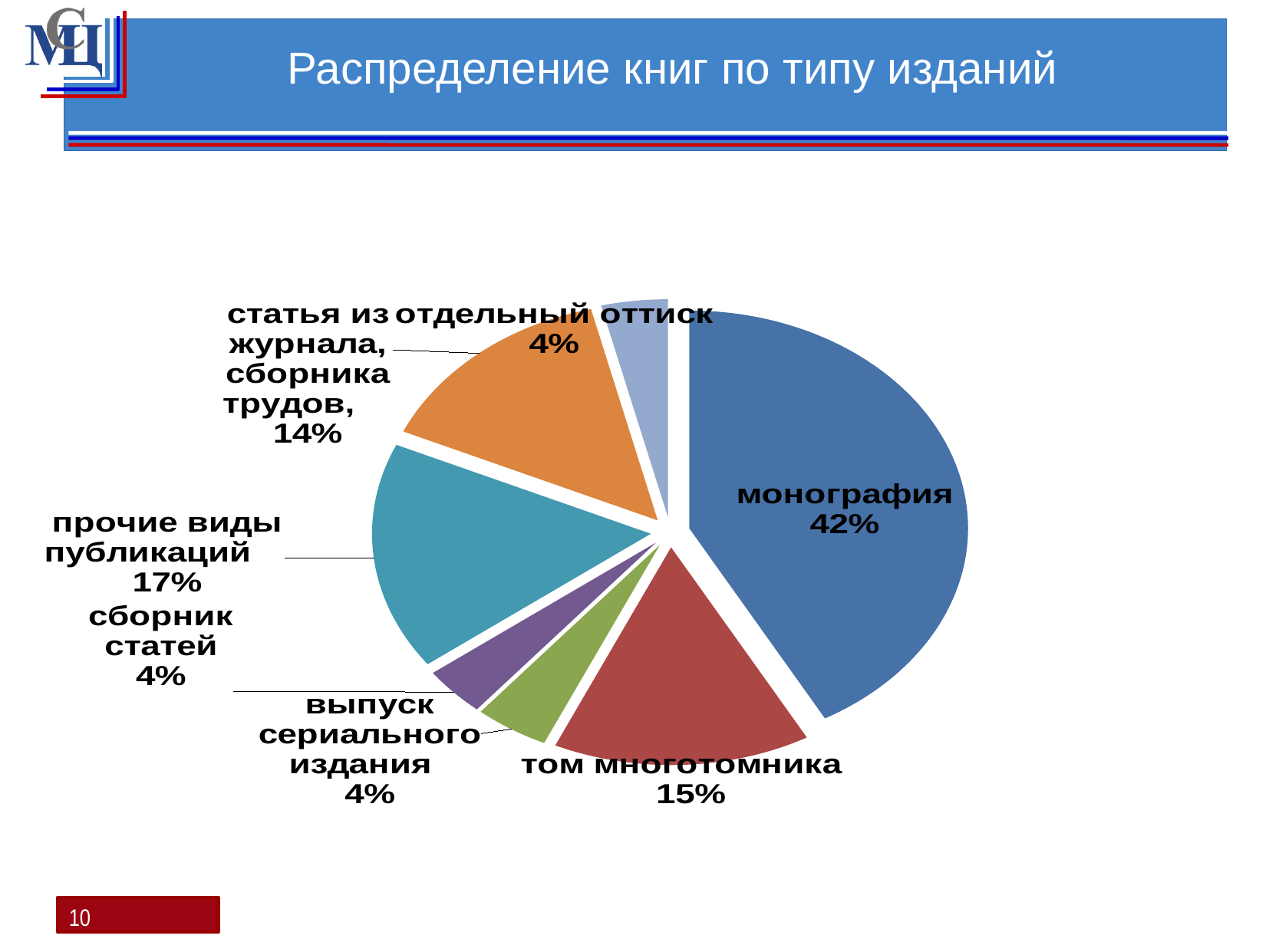
Which is larger, the share of прочие виды публикаций or the share of статья из журнала, сборника трудов? прочие виды публикаций What is the title of the chart on the slide? Распределение книг по типу изданий What share of the pie does прочие виды публикаций have? 17% What share of the pie does том многотомника have? 15% How many slices does the pie chart have? 7 What share of the pie does выпуск сериального издания have? 4% Which category has the largest slice of the pie? монография What is the difference between the shares of монография and том многотомника? 27% What kind of chart is shown on the slide? pie chart